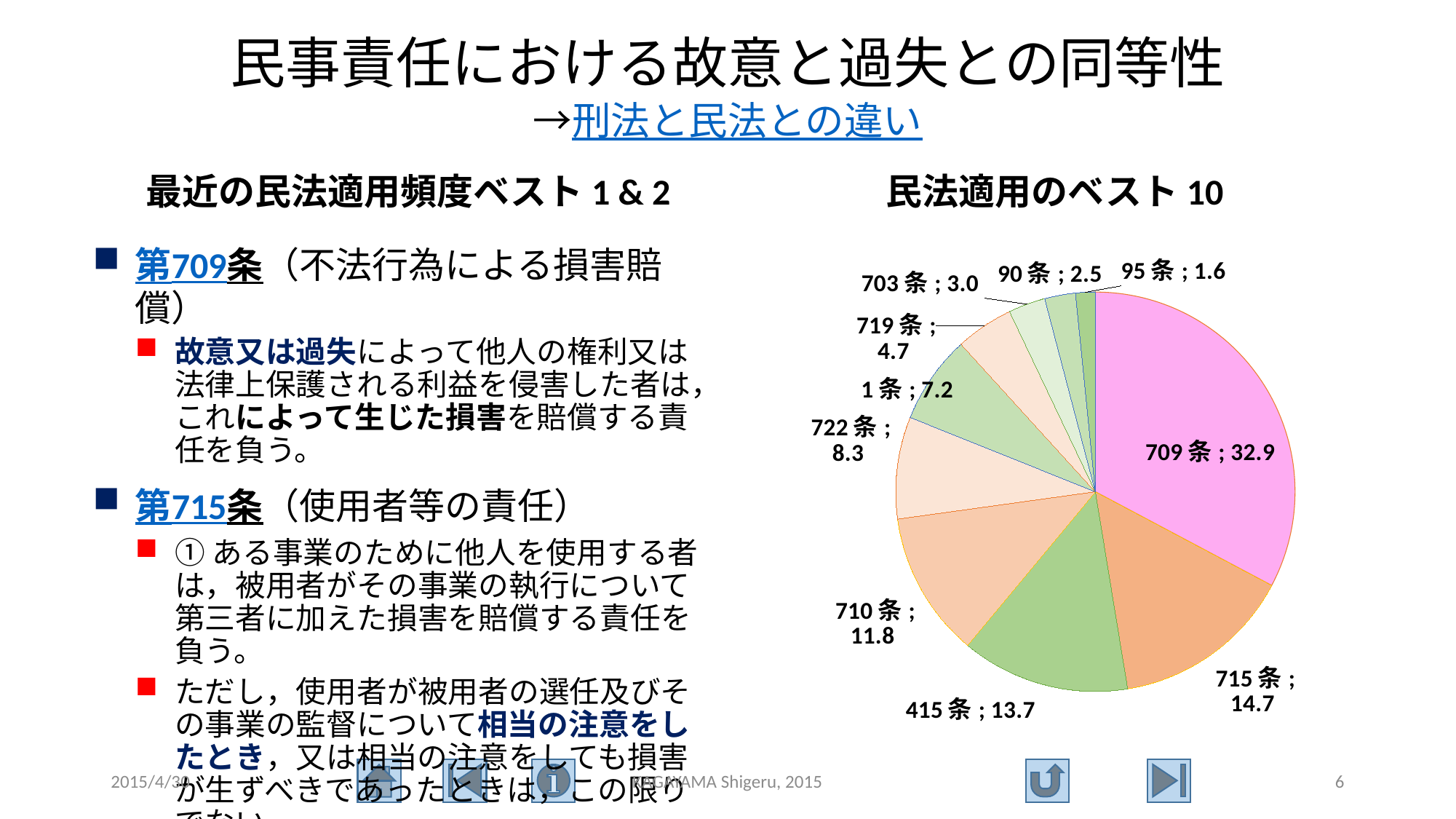
What kind of chart is shown on the slide? pie chart Which article has the smallest slice in the pie chart? 95条 What is the value shown for 722条 in the pie chart? 8.3 What is the difference between the values for 709条 and 715条 in the pie chart? 18.2 Which has a larger value in the pie chart, 710条 or 1条? 710条 What is the value shown for 90条 in the pie chart? 2.5 What is the value shown for 709条 in the pie chart? 32.9 What is the title of the chart on the slide? 民法適用のベスト 10 How many slices does the pie chart have? 10 Which article has the largest slice in the pie chart? 709条 What is the value shown for 715条 in the pie chart? 14.7 What is the value shown for 415条 in the pie chart? 13.7